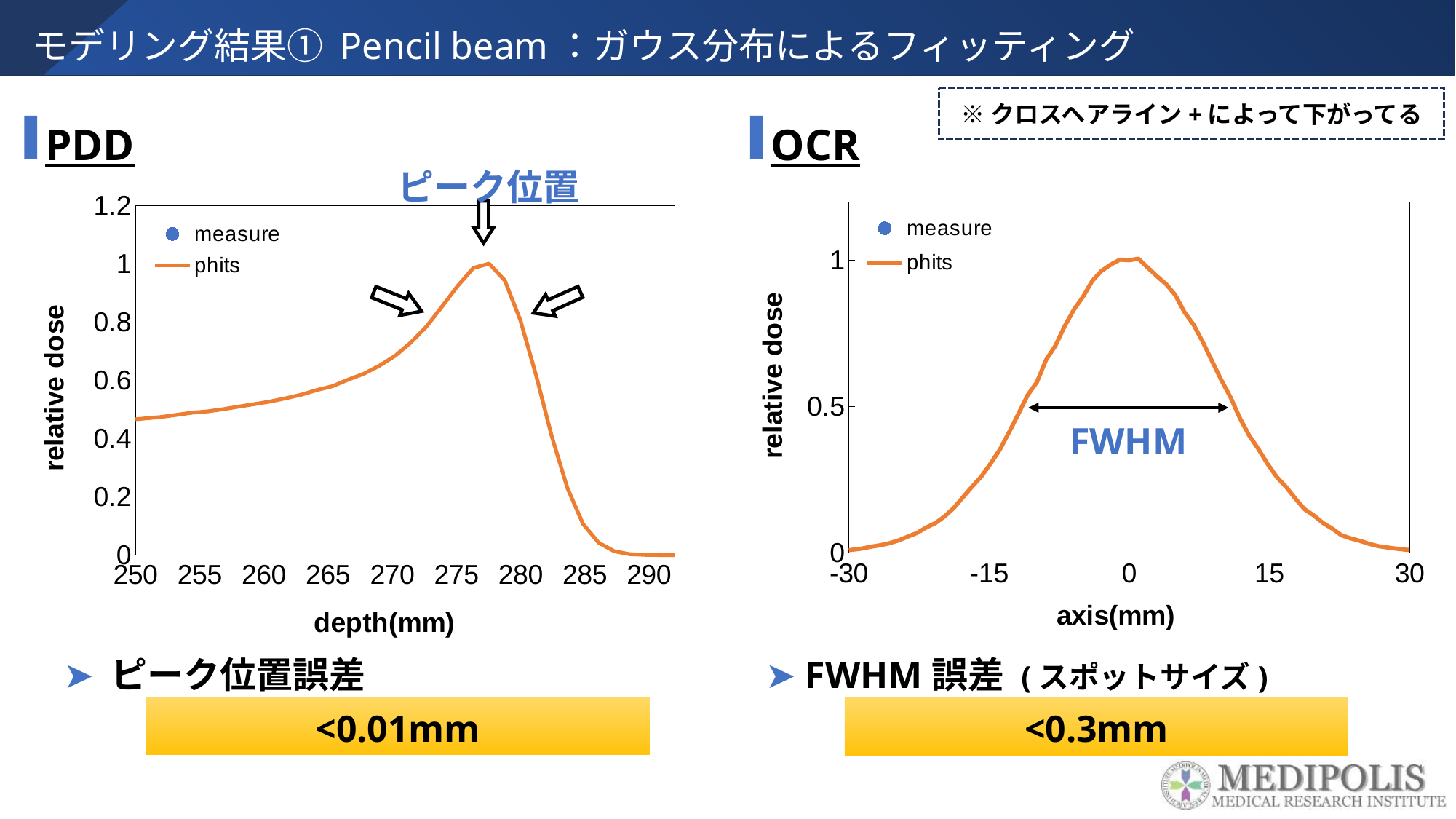
What is the x-axis label of the OCR chart? axis(mm) In the OCR chart, at which axis position does the phits curve reach its highest value? 0 In the PDD chart, does the phits curve rise or fall between depths of 250 mm and 275 mm? rise In the OCR chart, is the phits value at an axis position of -15 mm greater or less than 0.5? less In the PDD chart, is the phits value at a depth of 290 mm greater or less than 0.2? less In the PDD chart, is the phits value at a depth of 250 mm greater or less than 0.6? less What kind of chart is the PDD chart on the left? line chart In the PDD chart, does the phits curve rise or fall between depths of 280 mm and 290 mm? fall What are the two legend entries in the PDD chart? measure, phits How many series does the legend of the OCR chart list? 2